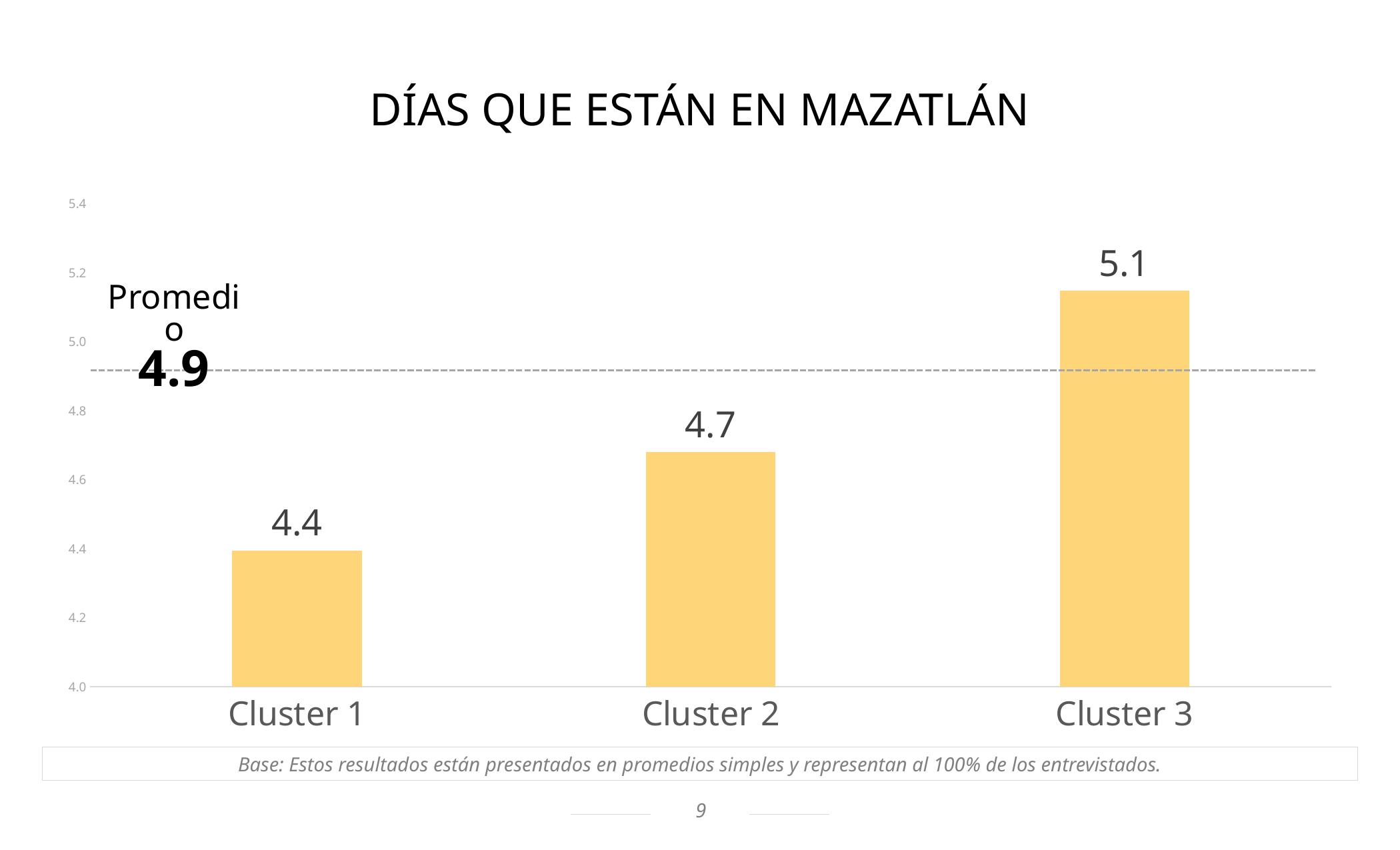
Which cluster has the highest value? Cluster 3 What is the value for Cluster 1? 4.4 Which cluster has the lowest value? Cluster 1 How many clusters are shown in the chart? 3 Is the value for Cluster 3 greater or less than 5.0? greater What is the difference between the values for Cluster 2 and Cluster 1? 0.3 What is the value for Cluster 3? 5.1 What kind of chart is shown on the slide? bar chart What is the value for Cluster 2? 4.7 What is the average (Promedio) value marked by the dashed line? 4.9 What is the difference between the values for Cluster 3 and Cluster 1? 0.7 Which is larger, the value for Cluster 2 or the value for Cluster 3? Cluster 3